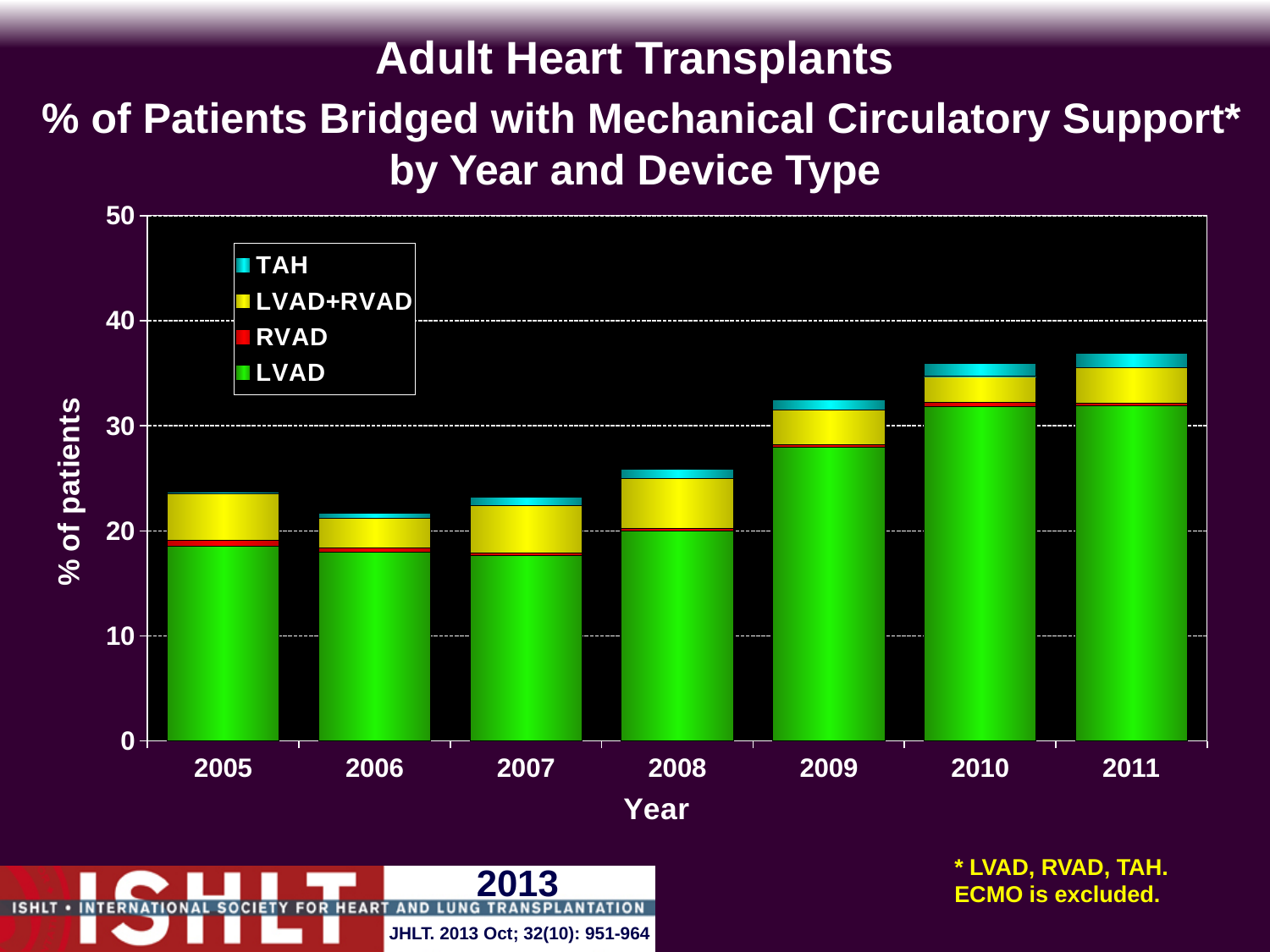
Which year has the lowest total percentage of patients bridged with mechanical circulatory support? 2006 Is the total value for 2005 greater or less than 20? greater What type of chart is shown on the slide? Stacked bar chart Is the total value for 2008 greater or less than 30? less How many years are shown on the x axis of the chart? 7 Is the LVAD value for 2005 greater or less than 20? less Which year has a larger total bar, 2006 or 2008? 2008 Which year has the highest total percentage of patients bridged with mechanical circulatory support? 2011 Which device type is shown in green in the chart? LVAD Do the total values rise or fall from 2007 to 2011? rise How many device types does the legend list? 4